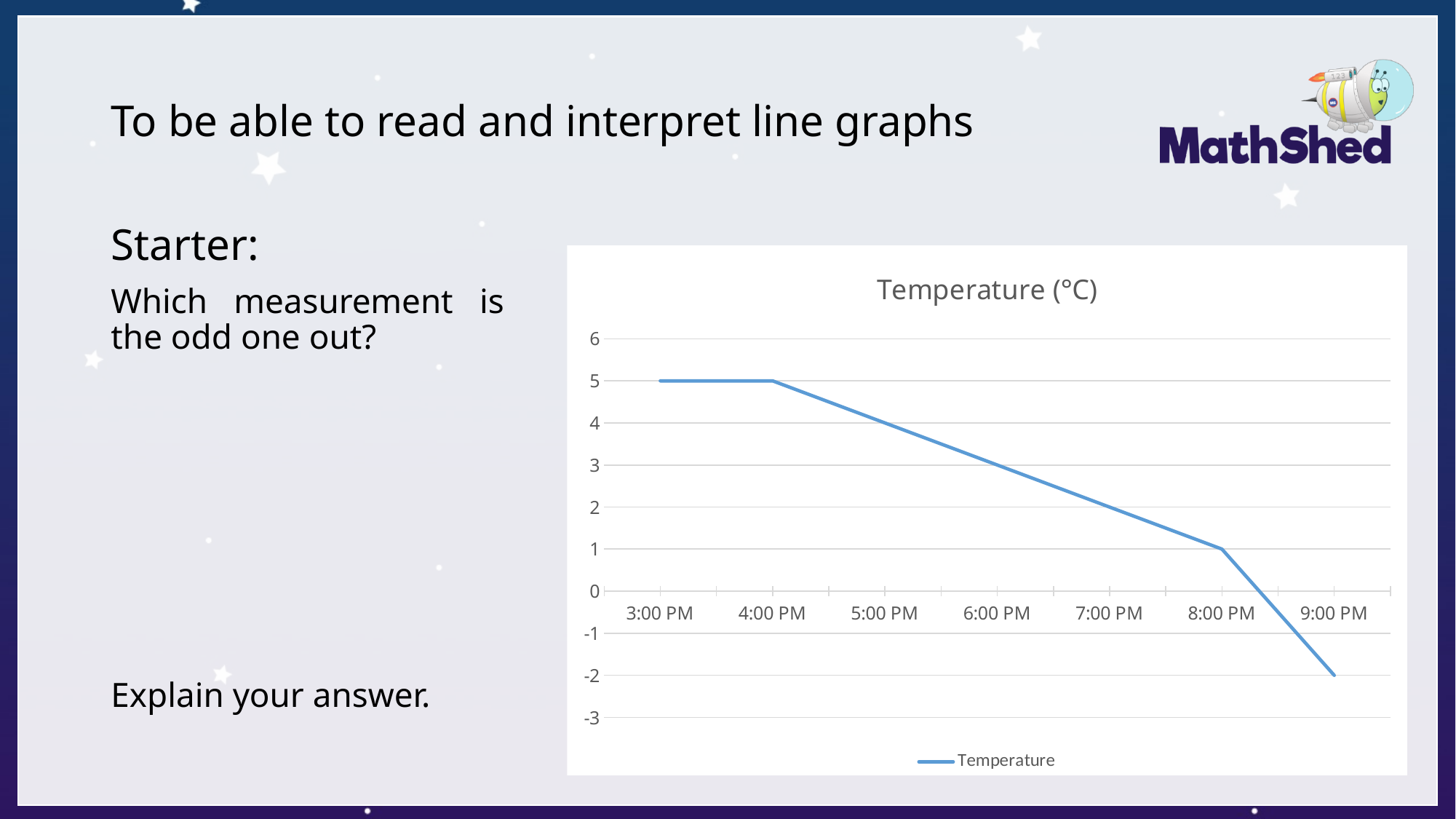
Does the temperature rise or fall from 4:00 PM to 9:00 PM? fall What is the temperature at 8:00 PM? 1 What is the temperature at 6:00 PM? 3 At which time is the temperature lowest? 9:00 PM What is the temperature at 9:00 PM? -2 What is the difference between the temperature at 4:00 PM and the temperature at 8:00 PM? 4 Is the temperature at 9:00 PM greater or less than 0? less How many time points are plotted on the x axis? 7 What is the temperature at 3:00 PM? 5 Which is higher, the temperature at 5:00 PM or the temperature at 7:00 PM? 5:00 PM What kind of chart is shown on the slide? line chart How many series does the legend list? 1